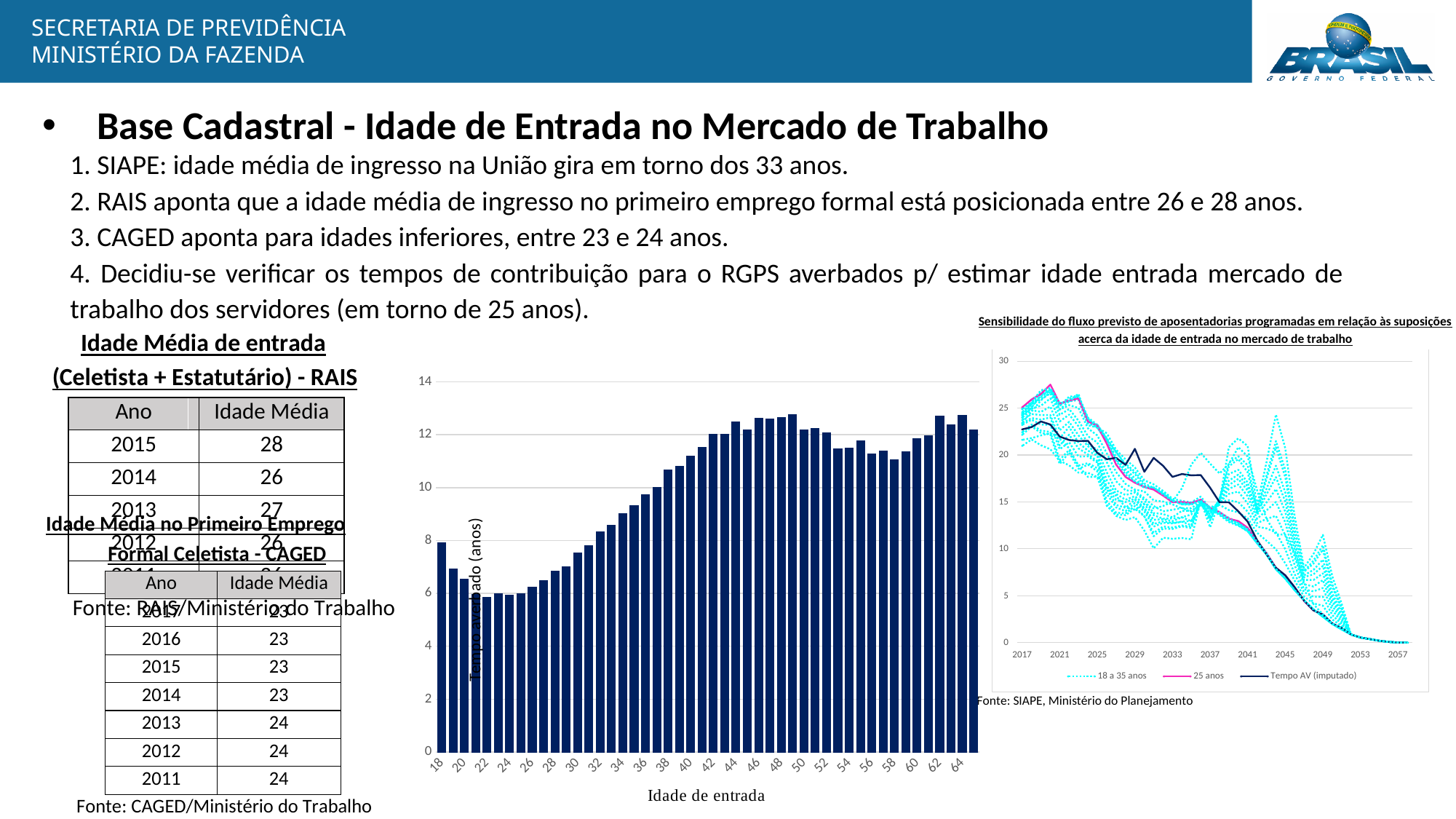
How many series does the legend of the right-hand line chart list? 3 What kind of chart is the middle chart with x axis 'Idade de entrada'? bar chart In the right-hand line chart, do the values generally rise or fall from 2017 to 2057? fall In the middle bar chart, is the value for entry age 46 greater or less than 12? greater In the right-hand line chart, is the value of 'Tempo AV (imputado)' in 2017 greater or less than 20? greater In the middle bar chart, which has the larger value: entry age 30 or entry age 46? 46 In the middle bar chart, what is the label of the vertical axis? Tempo averbado (anos) In the middle bar chart, is the value for entry age 58 greater or less than 12? less What kind of chart is the right-hand chart titled 'Sensibilidade do fluxo previsto de aposentadorias programadas...'? line chart In the middle bar chart, which has the larger value: entry age 18 or entry age 22? 18